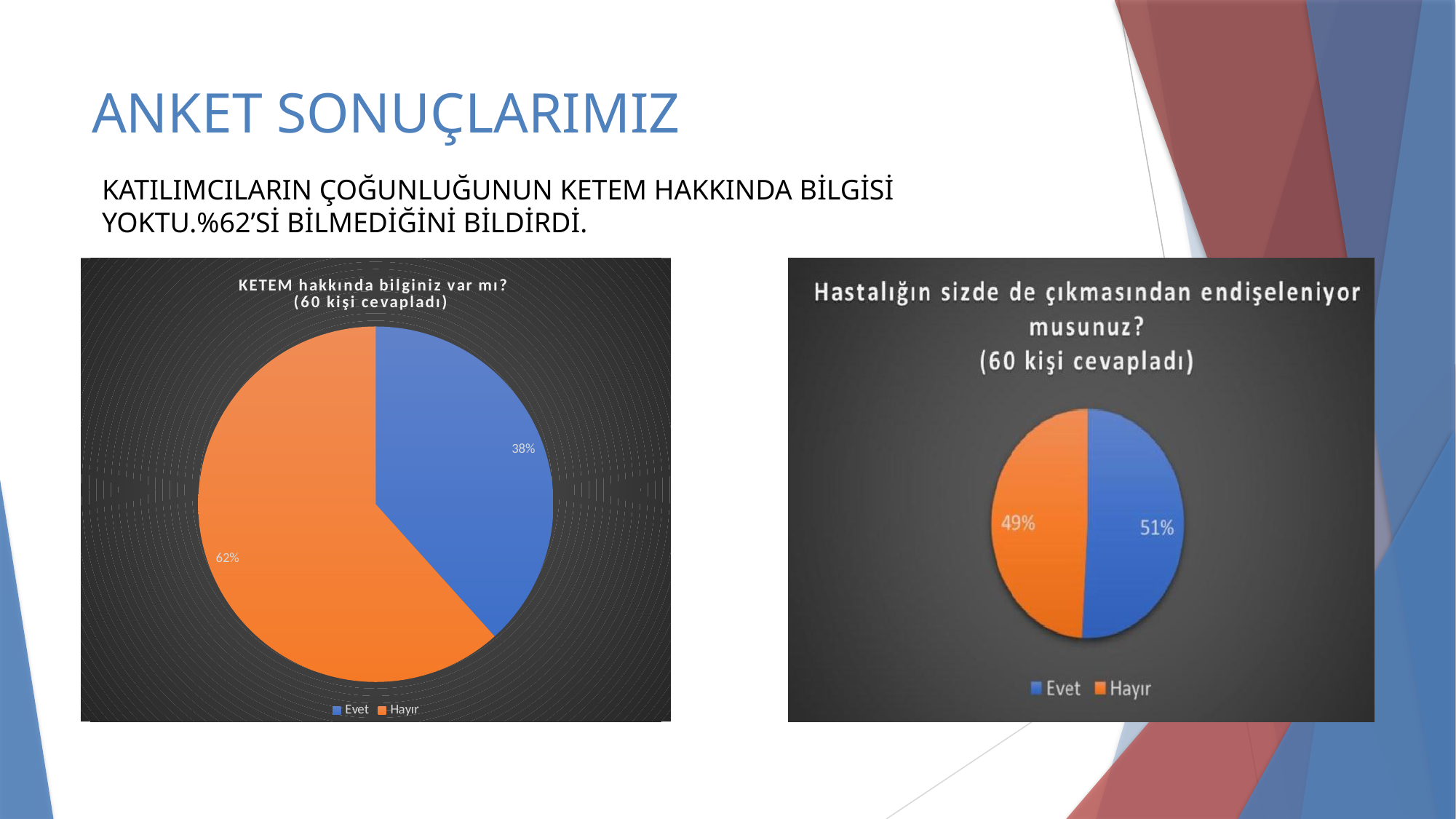
In the right chart titled 'Hastalığın sizde de çıkmasından endişeleniyor musunuz?', what percentage is shown for Evet? 51% In the left chart titled 'KETEM hakkında bilginiz var mı?', how many people answered according to the title? 60 In the left chart titled 'KETEM hakkında bilginiz var mı?', which answer has the largest share? Hayır In the right chart titled 'Hastalığın sizde de çıkmasından endişeleniyor musunuz?', what colour represents Hayır in the legend? Orange In the right chart titled 'Hastalığın sizde de çıkmasından endişeleniyor musunuz?', what is the difference in percentage points between Evet and Hayır? 2 In the left chart titled 'KETEM hakkında bilginiz var mı?', what is the difference in percentage points between Hayır and Evet? 24 How many slices does the right chart titled 'Hastalığın sizde de çıkmasından endişeleniyor musunuz?' have? 2 What type of chart is the left chart titled 'KETEM hakkında bilginiz var mı?'? Pie chart In the right chart titled 'Hastalığın sizde de çıkmasından endişeleniyor musunuz?', what percentage is shown for Hayır? 49% In the left chart titled 'KETEM hakkında bilginiz var mı?', what percentage is shown for Hayır? 62% In the left chart titled 'KETEM hakkında bilginiz var mı?', which answer has the smallest share? Evet In the left chart titled 'KETEM hakkında bilginiz var mı?', what percentage is shown for Evet? 38%